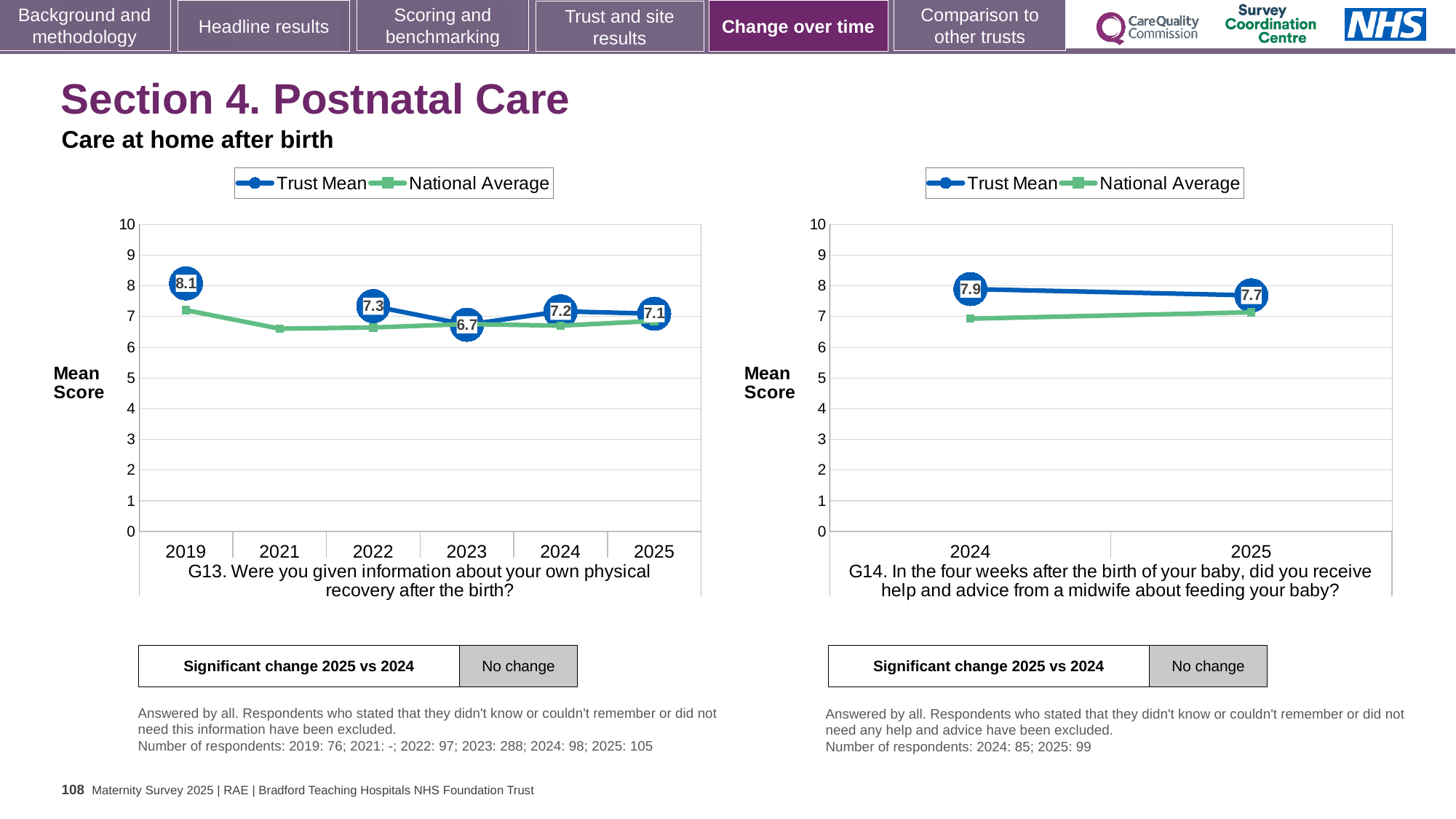
How many years are shown on the x axis of the G13 chart on the left? 6 In the G13 chart on the left, is the National Average for 2021 greater or less than 7? less In the G13 chart on the left, which year has the highest Trust Mean? 2019 In the G13 chart on the left, what is the Trust Mean for 2023? 6.7 In the G13 chart on the left, is the Trust Mean higher in 2022 or in 2024? 2022 In the G14 chart on the right, what is the difference between the Trust Mean in 2024 and in 2025? 0.2 In the G13 chart on the left, which year has the lowest labelled Trust Mean? 2023 In the G14 chart on the right, what is the Trust Mean for 2025? 7.7 How many series does the legend of the G14 chart on the right list? 2 In the G14 chart on the right, does the Trust Mean rise or fall from 2024 to 2025? fall In the G13 chart on the left, what is the difference between the Trust Mean in 2019 and in 2025? 1.0 In the G13 chart on the left, what is the Trust Mean for 2019? 8.1